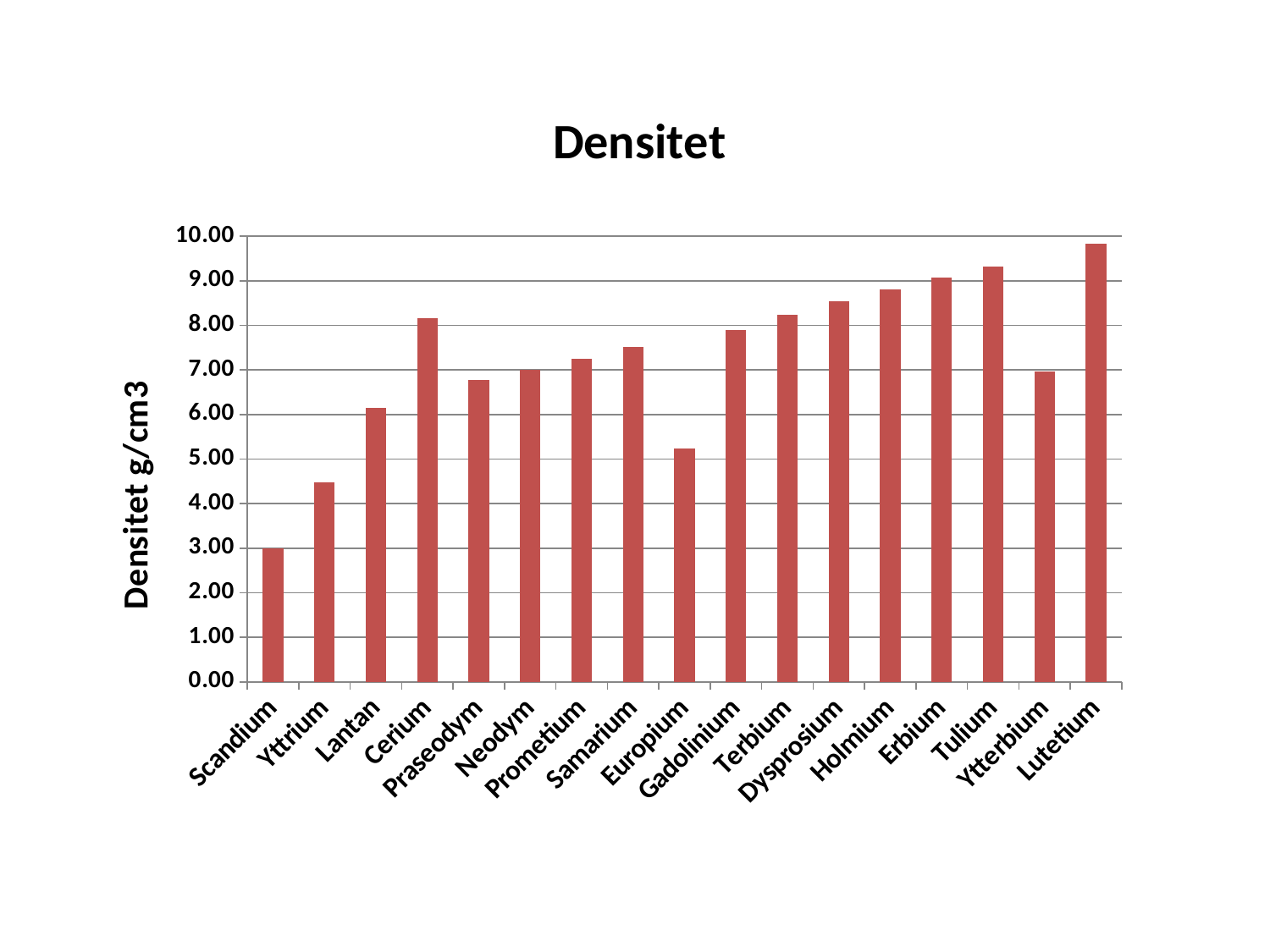
Which has the larger value, Yttrium or Lantan? Lantan Which element has the highest density in the chart? Lutetium Is the value for Yttrium greater or less than 5.00? less What is the title of the chart? Densitet Is the value for Holmium greater or less than 9.00? less What is the label on the vertical axis of the chart? Densitet g/cm3 Which element has the lowest density in the chart? Scandium Which has the larger value, Cerium or Europium? Cerium What kind of chart is shown on the slide? bar chart How many elements (categories) are plotted in the chart? 17 Is the value for Tulium greater or less than 9.00? greater